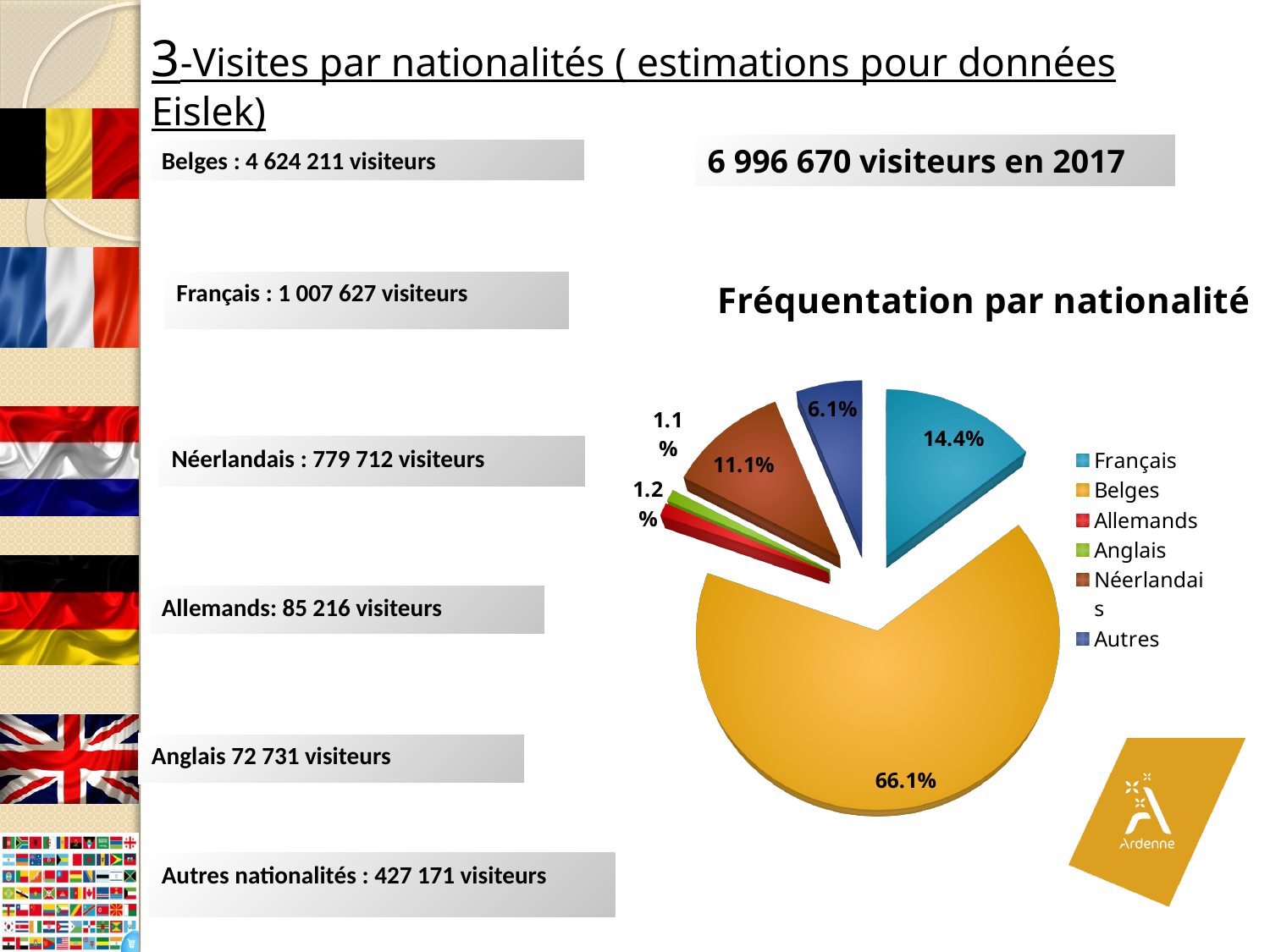
What is the title of the chart on the slide? Fréquentation par nationalité What type of chart is shown on the slide? Pie chart What percentage is shown for Allemands in the pie chart? 1.2% How many entries does the legend of the pie chart list? 6 How many slices does the pie chart have? 6 Which nationality has the largest slice in the pie chart? Belges What percentage is shown for Néerlandais in the pie chart? 11.1% What percentage of the pie chart does the Belges slice represent? 66.1% What is the difference in percentage points between the Belges slice and the Français slice? 51.7 What percentage is shown for the Français slice in the pie chart? 14.4% Which is larger in the pie chart, the Français slice or the Néerlandais slice? Français What percentage does the Autres slice represent in the pie chart? 6.1%